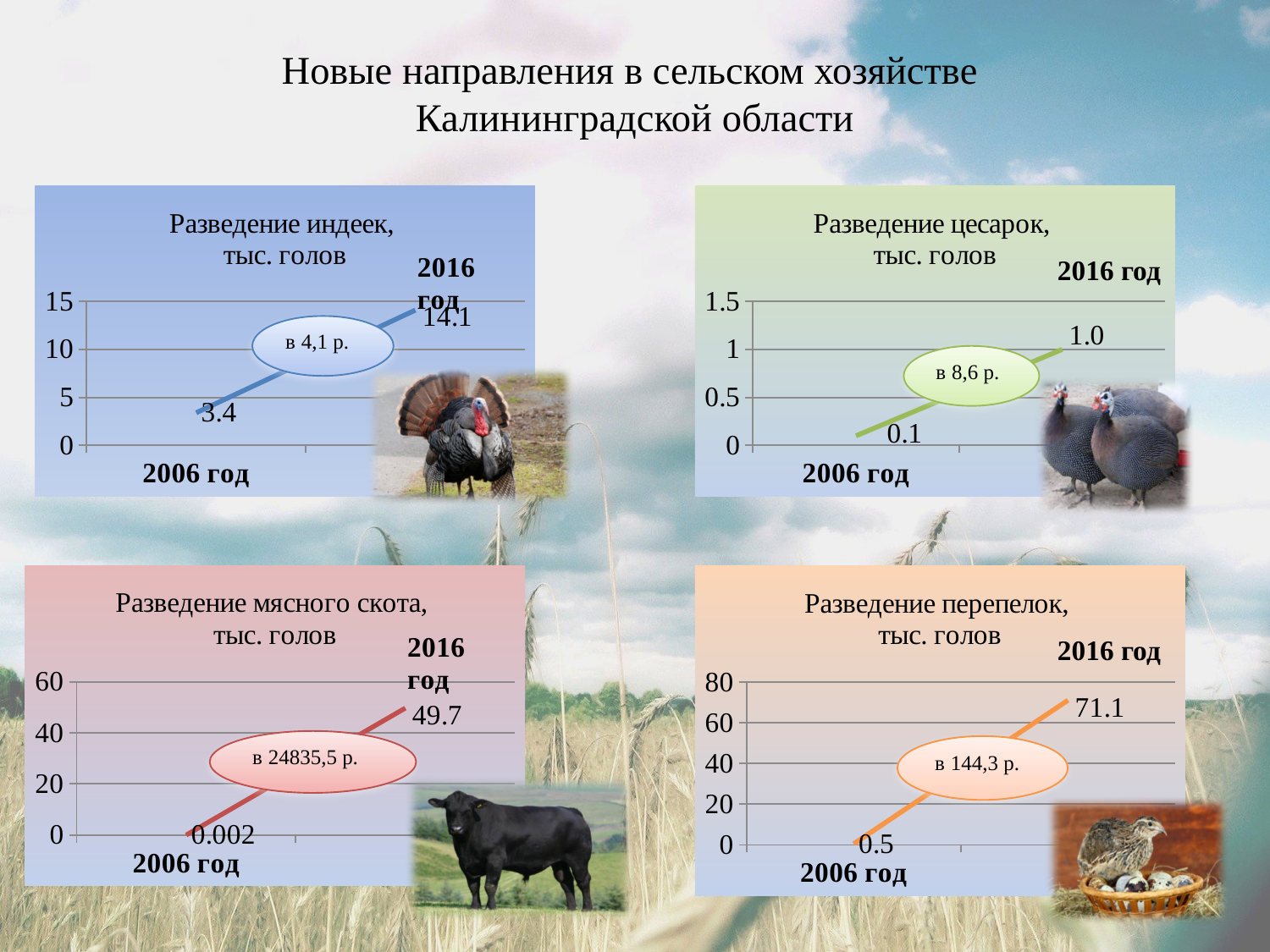
In the chart 'Разведение мясного скота, тыс. голов', what is the value for 2006 год? 0.002 In the chart 'Разведение цесарок, тыс. голов', what is the value for 2006 год? 0.1 In the chart 'Разведение перепелок, тыс. голов', what is the difference between the 2016 год and 2006 год values? 70.6 In the chart 'Разведение индеек, тыс. голов', what is the value for 2006 год? 3.4 How many data points are plotted in the chart 'Разведение перепелок, тыс. голов'? 2 In the chart 'Разведение цесарок, тыс. голов', do the values rise or fall from 2006 год to 2016 год? rise What kind of chart is 'Разведение мясного скота, тыс. голов'? line chart In the chart 'Разведение цесарок, тыс. голов', what is the value for 2016 год? 1.0 In the chart 'Разведение индеек, тыс. голов', what is the difference between the 2016 год and 2006 год values? 10.7 In the chart 'Разведение перепелок, тыс. голов', what is the value for 2016 год? 71.1 In the chart 'Разведение мясного скота, тыс. голов', what is the value for 2016 год? 49.7 In the chart 'Разведение индеек, тыс. голов', what is the value for 2016 год? 14.1